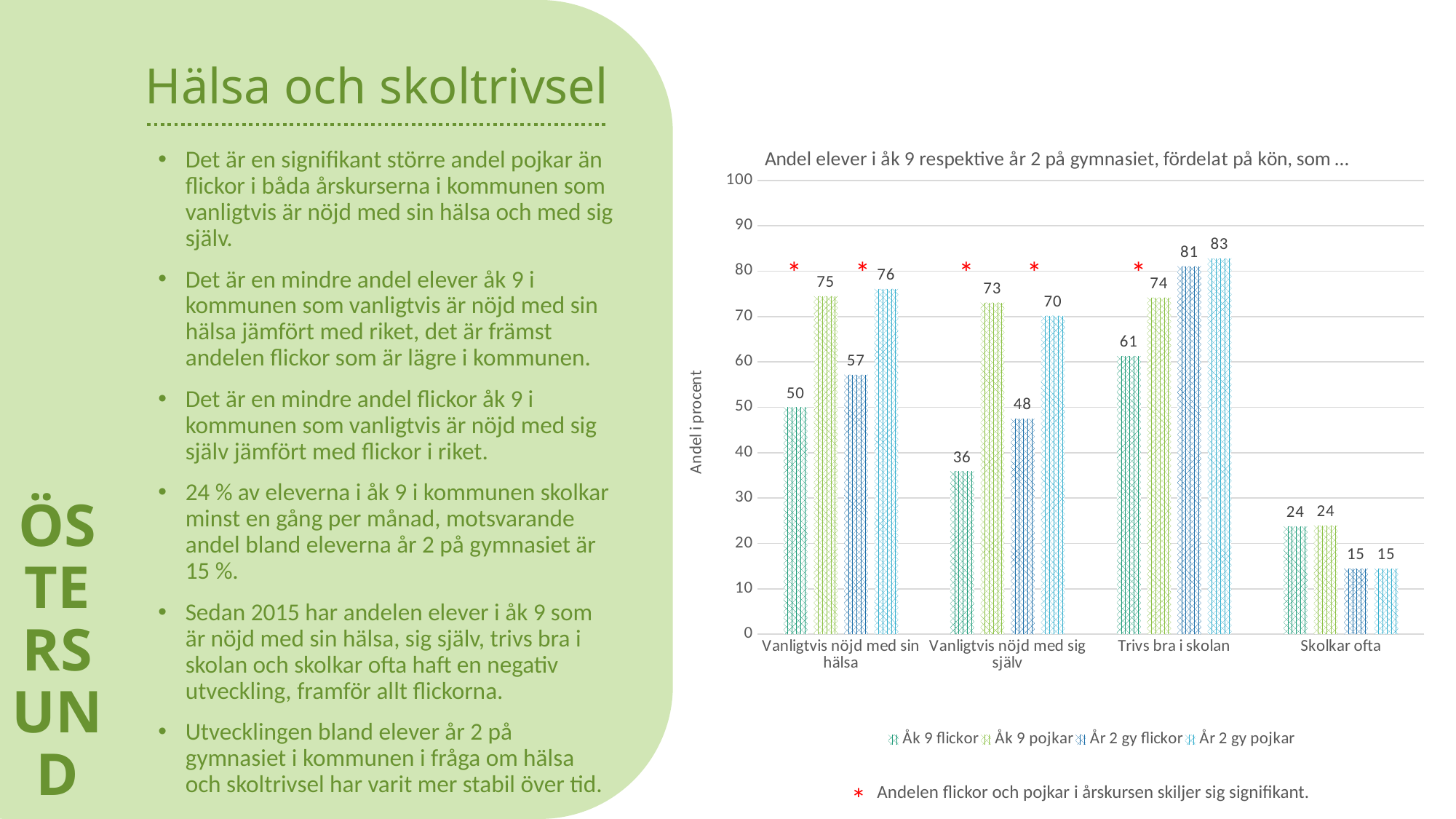
What value is shown for Åk 9 flickor in the category 'Vanligtvis nöjd med sin hälsa'? 50 Which series has the lowest value in the category 'Vanligtvis nöjd med sig själv'? Åk 9 flickor How many series does the chart legend list? 4 How many categories are shown on the x axis of the chart? 4 What is the difference between Åk 9 pojkar and Åk 9 flickor in the category 'Vanligtvis nöjd med sin hälsa'? 25 What type of chart is shown on the slide? Bar chart What value is shown for Åk 9 pojkar in the category 'Vanligtvis nöjd med sig själv'? 73 Which series has the highest value in the category 'Trivs bra i skolan'? År 2 gy pojkar What value is shown for År 2 gy flickor in the category 'Skolkar ofta'? 15 Which is larger in the category 'Trivs bra i skolan': Åk 9 flickor or År 2 gy flickor? År 2 gy flickor What value is shown for År 2 gy pojkar in the category 'Trivs bra i skolan'? 83 What is the label of the y axis of the chart? Andel i procent